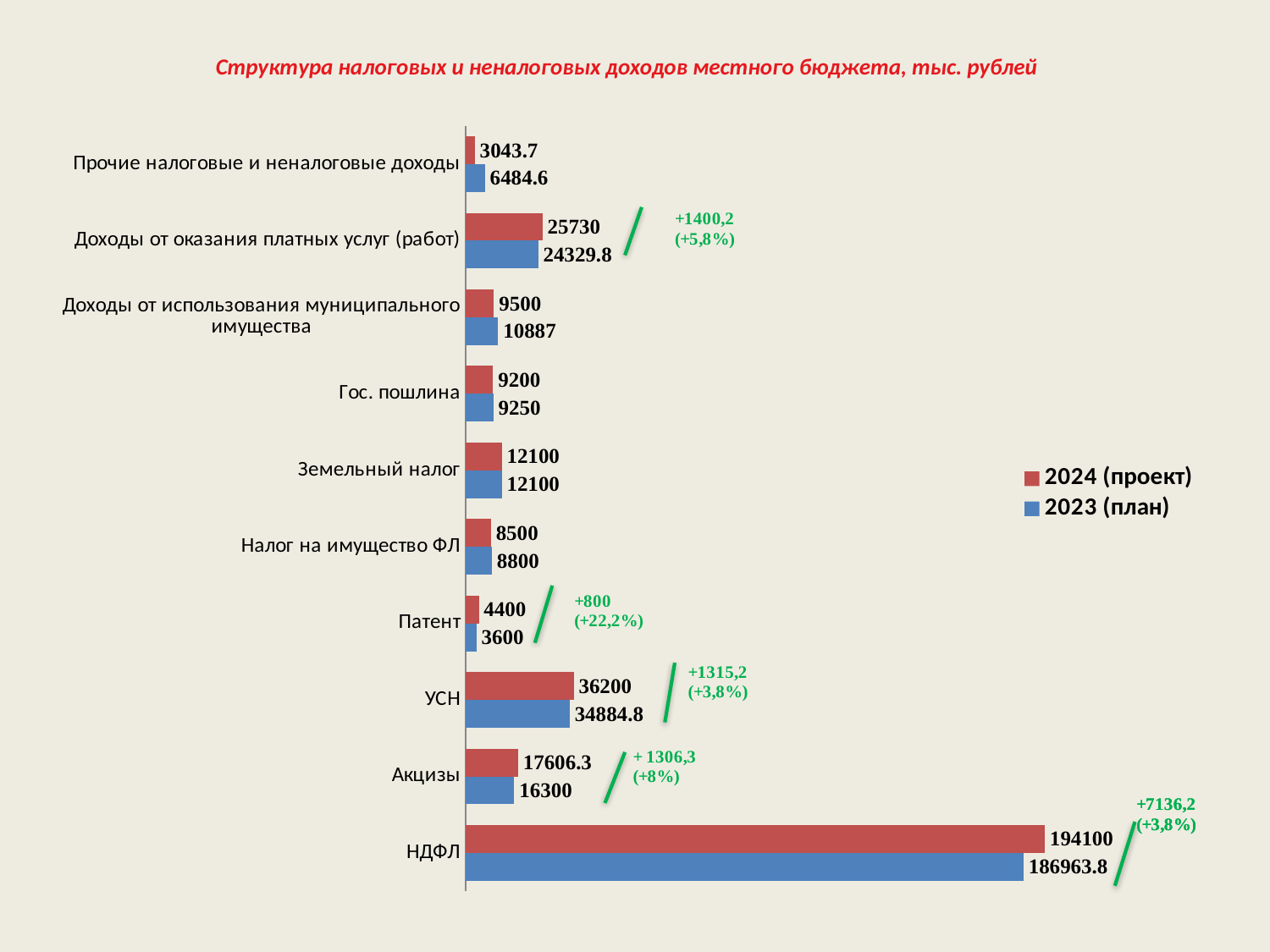
What is the difference between the 2024 (проект) and 2023 (план) values for Патент? 800 Which category has the highest 2024 (проект) value? НДФЛ What is the 2023 (план) value for УСН? 34884.8 How many series does the legend list? 2 How many categories are shown on the chart? 10 What is the 2023 (план) value for Прочие налоговые и неналоговые доходы? 6484.6 What is the 2024 (проект) value for НДФЛ? 194100 Which is larger for Доходы от использования муниципального имущества: the 2024 (проект) value or the 2023 (план) value? 2023 (план) What kind of chart is shown on the slide? Bar chart Which category has the lowest 2023 (план) value? Патент What is the 2024 (проект) value for Акцизы? 17606.3 Which colour represents the 2023 (план) series? Blue